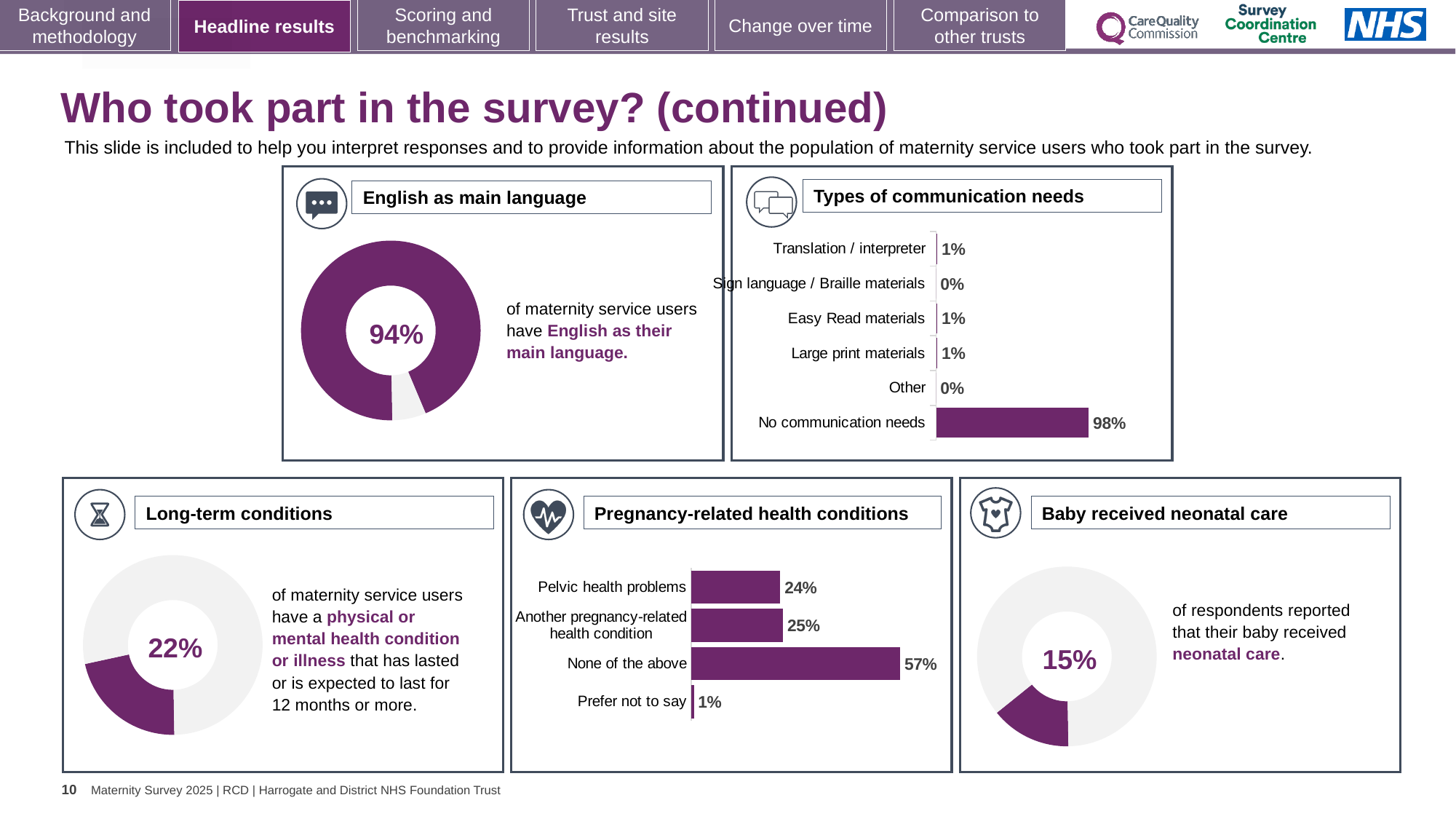
What kind of chart is the 'Baby received neonatal care' chart? Donut chart In the 'Types of communication needs' chart, what is the value for 'No communication needs'? 98% In the 'Pregnancy-related health conditions' chart, which category has the lowest value? Prefer not to say In the 'English as main language' chart, what percentage of maternity service users have English as their main language? 94% In the 'Pregnancy-related health conditions' chart, what is the value for 'None of the above'? 57% In the 'Long-term conditions' chart, what percentage of maternity service users have a physical or mental health condition or illness? 22% In the 'Types of communication needs' chart, which category has the highest value? No communication needs In the 'Pregnancy-related health conditions' chart, what is the difference between 'Another pregnancy-related health condition' and 'Pelvic health problems'? 1% In the 'Baby received neonatal care' chart, what percentage of respondents reported that their baby received neonatal care? 15% What kind of chart is the 'Types of communication needs' chart? Bar chart In the 'Types of communication needs' chart, what is the value for 'Translation / interpreter'? 1% How many categories are shown in the 'Types of communication needs' chart? 6